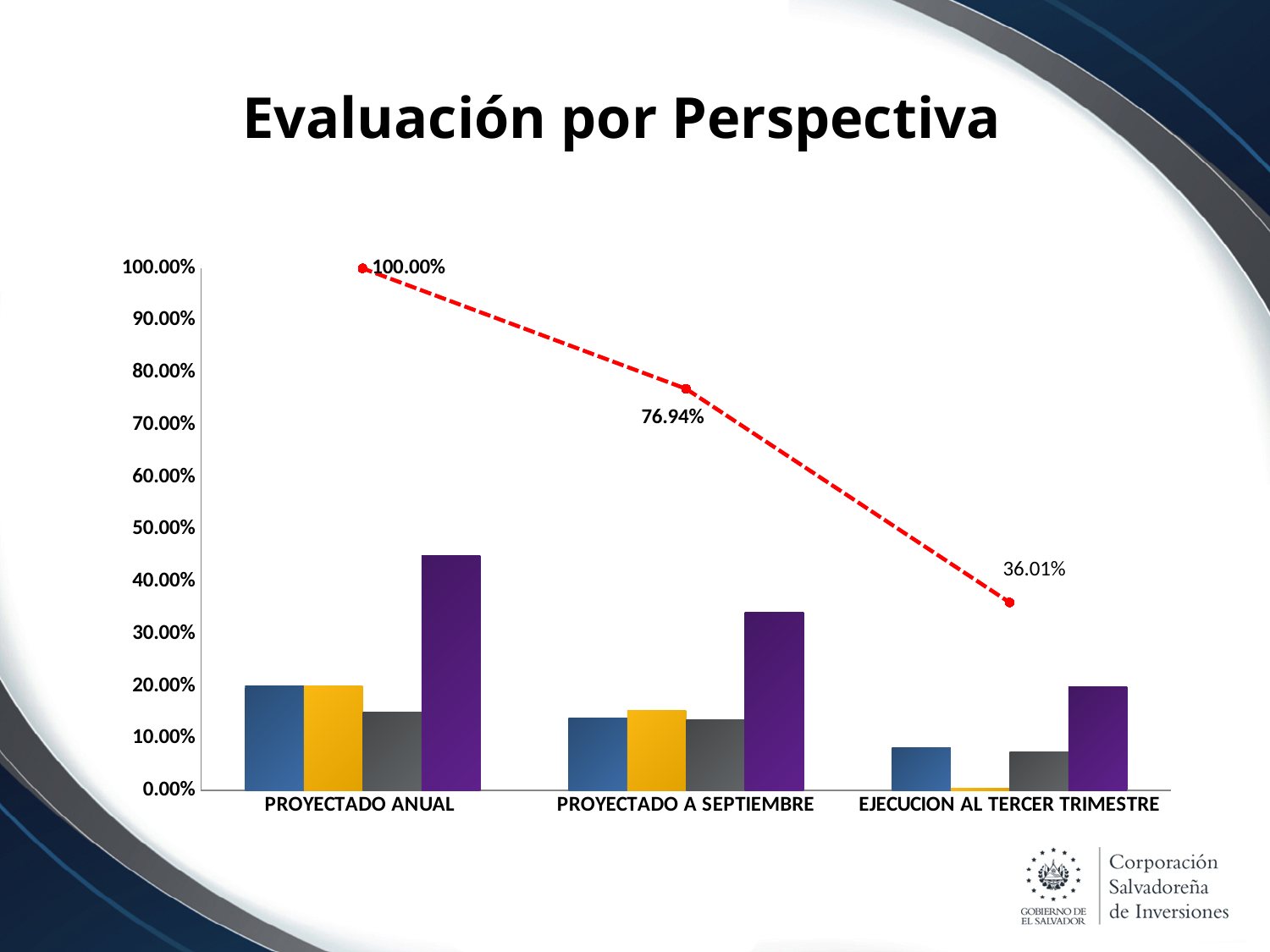
What is the value of the dashed red line at PROYECTADO A SEPTIEMBRE? 76.94% How many categories are shown on the x axis? 3 What is the title of the slide containing the chart? Evaluación por Perspectiva What is the difference between the line values at PROYECTADO ANUAL and PROYECTADO A SEPTIEMBRE? 23.06% At which category does the dashed red line reach its lowest value? EJECUCION AL TERCER TRIMESTRE Is the value of the purple bar for PROYECTADO ANUAL greater or less than 40.00%? greater What is the value of the dashed red line at EJECUCION AL TERCER TRIMESTRE? 36.01% What is the difference between the line values at PROYECTADO A SEPTIEMBRE and EJECUCION AL TERCER TRIMESTRE? 40.93% Is the value of the blue bar for EJECUCION AL TERCER TRIMESTRE greater or less than 10.00%? less Does the dashed red line rise or fall from left to right across the categories? fall At which category does the dashed red line reach its highest value? PROYECTADO ANUAL What is the value of the dashed red line at PROYECTADO ANUAL? 100.00%